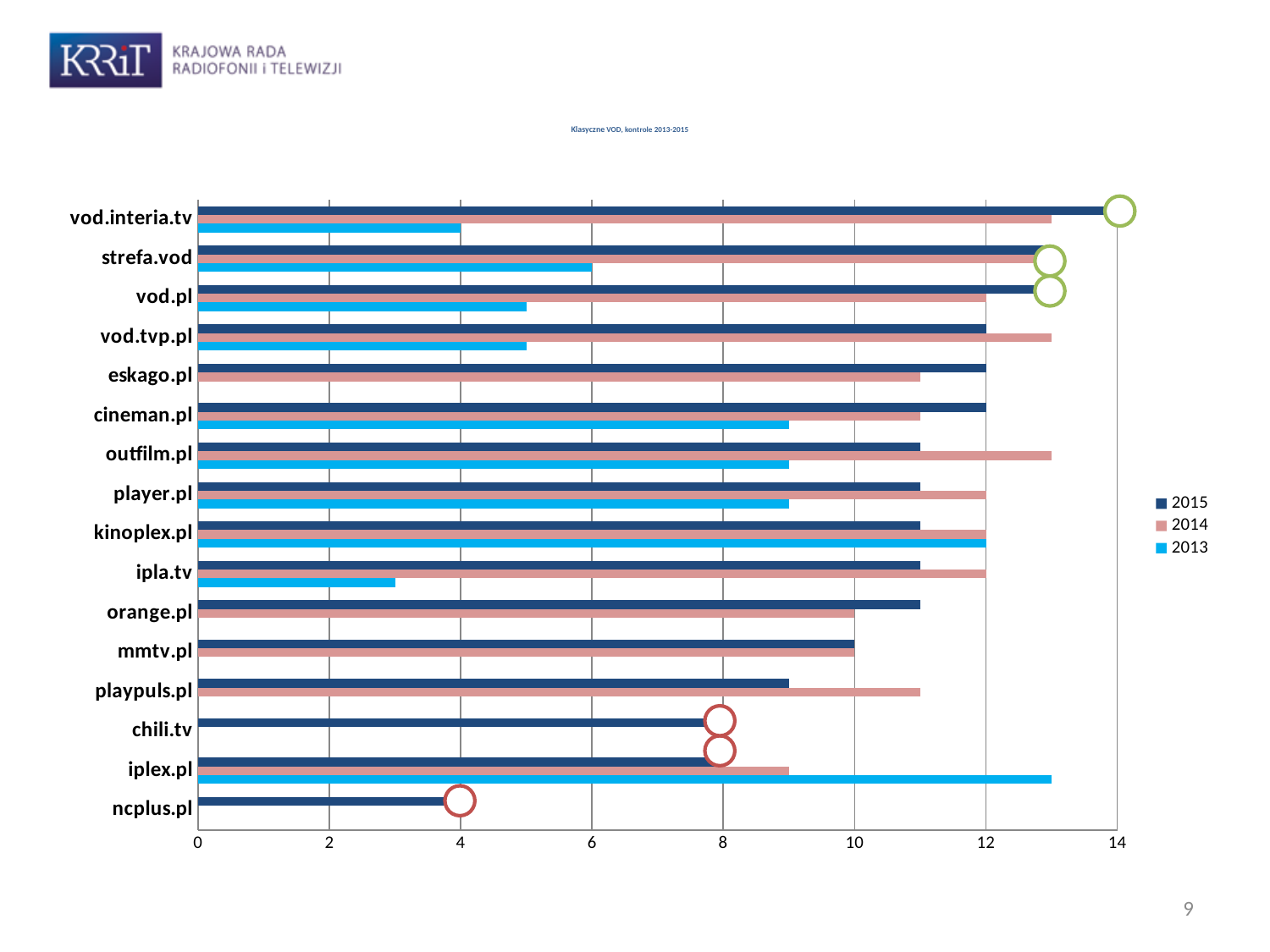
What is the 2013 value for kinoplex.pl? 12 Is the 2013 value for iplex.pl greater or less than 12? greater How many series does the legend list? 3 Which series is shown in dark blue in the legend? 2015 What is the 2013 value for vod.interia.tv? 4 Is the 2013 value for ipla.tv greater or less than 4? less What is the 2014 value for mmtv.pl? 10 What is the 2013 value for strefa.vod? 6 For iplex.pl, which is larger: the 2013 value or the 2015 value? 2013 How many categories (services) are shown on the vertical axis? 16 What kind of chart is shown on the slide? bar chart Which category has the longest 2015 bar? vod.interia.tv